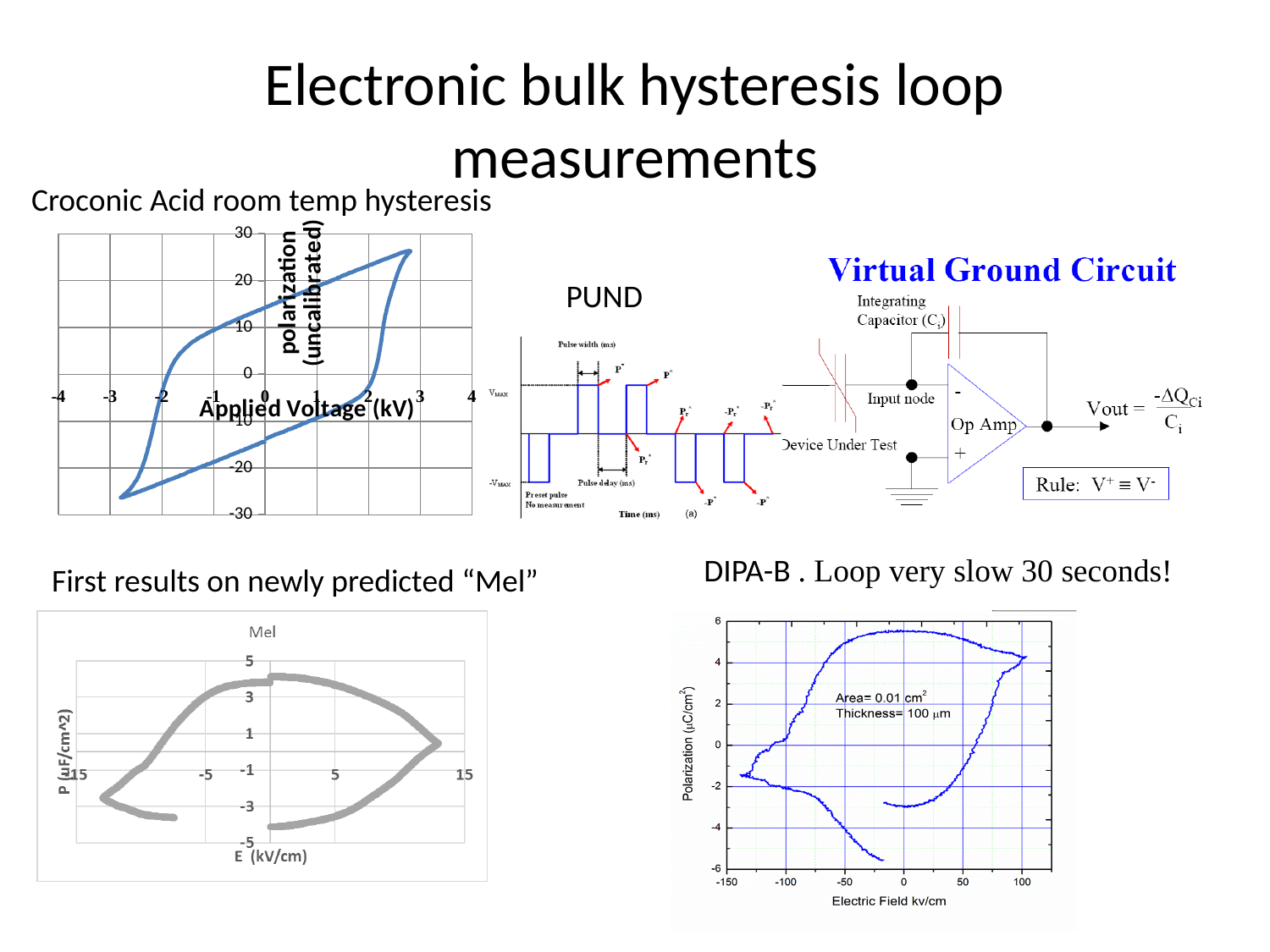
In the Mel chart, is the lowest P value on the loop greater or less than -3? less In the Croconic Acid room temp hysteresis chart, is the minimum polarization reached by the loop greater or less than -20? less What kind of chart is the Croconic Acid room temp hysteresis chart? line chart (hysteresis loop) In the DIPA-B chart, is the lowest polarization value plotted greater or less than -4? less What kind of chart is the Mel chart? scatter/line chart (hysteresis loop) What is the x-axis label of the Mel chart? E (kV/cm) What is the y-axis label of the DIPA-B chart? Polarization (μC/cm²) How many hysteresis loop charts are shown on the slide? 3 In the DIPA-B chart, what sample area is stated in the annotation? 0.01 cm²